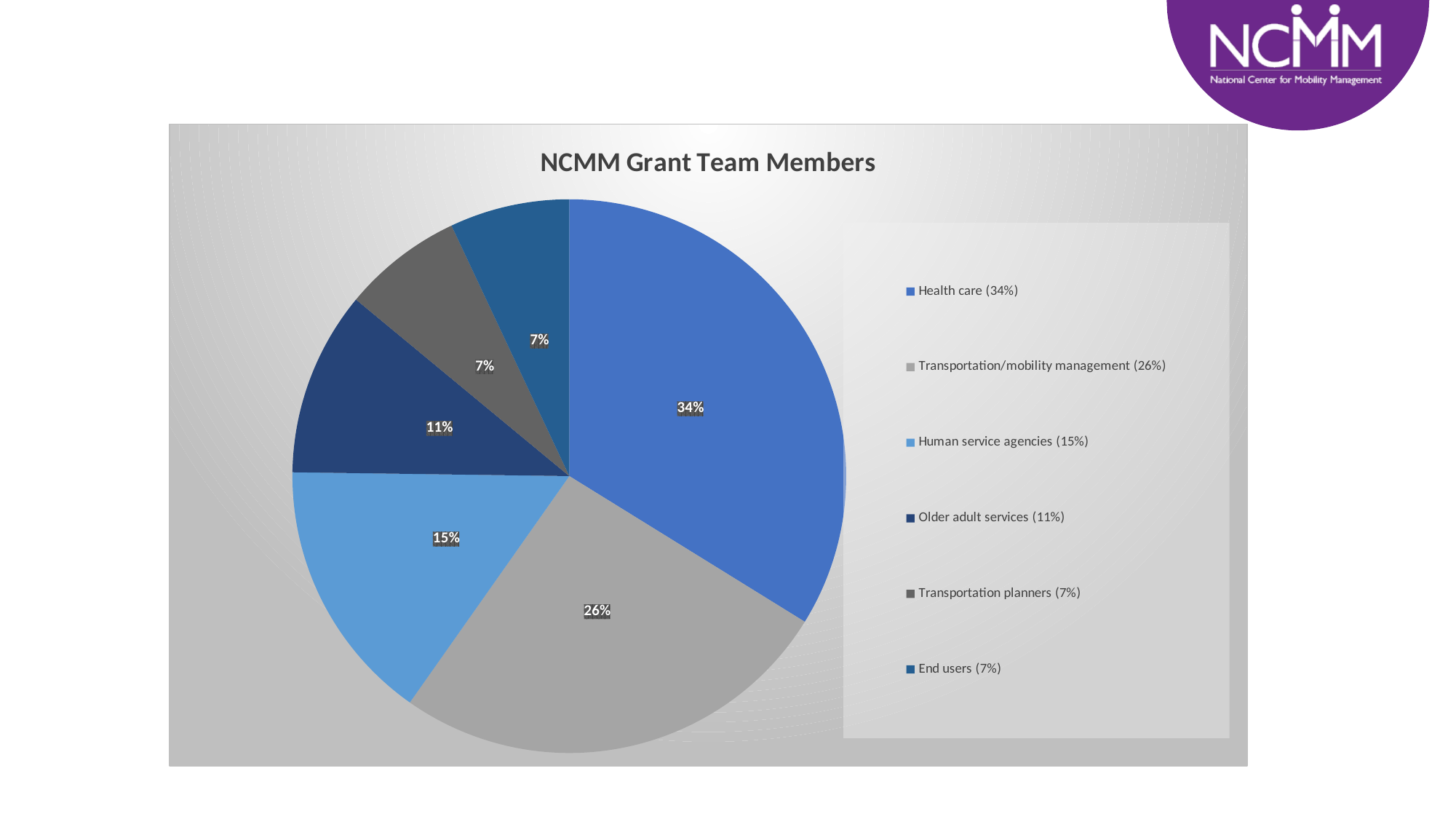
What share of the pie is Transportation/mobility management? 26% What is the difference in percentage points between Health care and Transportation/mobility management? 8 How many categories does the legend list? 6 Which is larger, the share for Human service agencies or the share for Older adult services? Human service agencies What kind of chart is shown on the slide? Pie chart What is the title of the chart? NCMM Grant Team Members Which category has the largest slice of the pie? Health care Which two categories each have a 7% share? Transportation planners and End users What share of the pie is Human service agencies? 15% What share of the pie is Older adult services? 11% What is the combined share of Transportation planners and End users? 14%